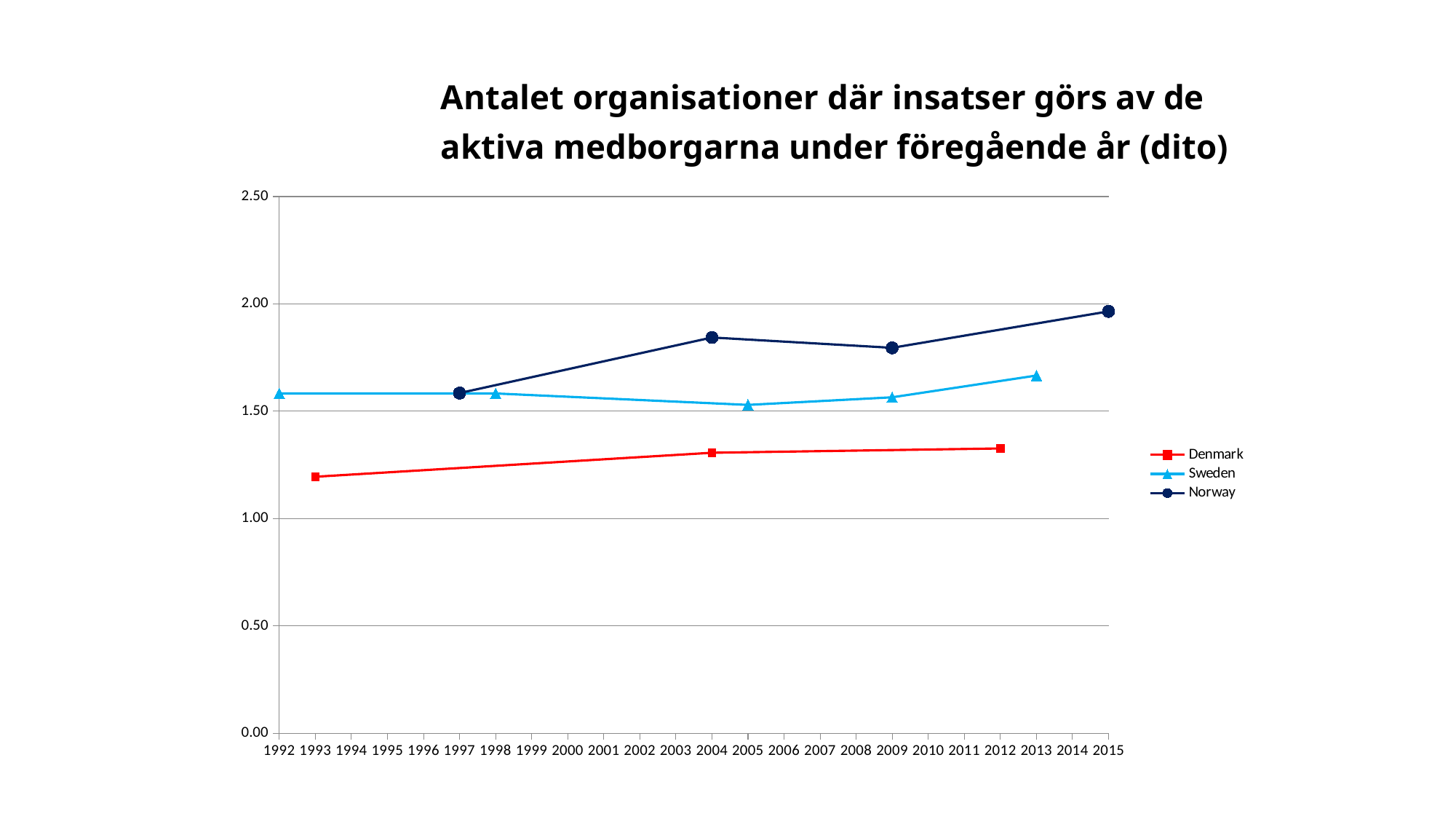
Which is larger: the value for Norway in 2004 or the value for Sweden in 2005? Norway in 2004 Is the value for Denmark in 1993 greater or less than 1.50? less How many series does the legend list? 3 Does the Denmark line rise or fall from 1993 to 2012? rise Which series reaches the highest value on the chart? Norway Is the value for Denmark in 2012 greater or less than 1.00? greater Is the value for Norway in 2004 greater or less than 1.50? greater How many data points are plotted for Denmark? 3 Which is larger: the value for Denmark in 2004 or the value for Sweden in 1998? Sweden in 1998 Which series are listed in the legend? Denmark, Sweden, Norway What kind of chart is shown on the slide? line chart